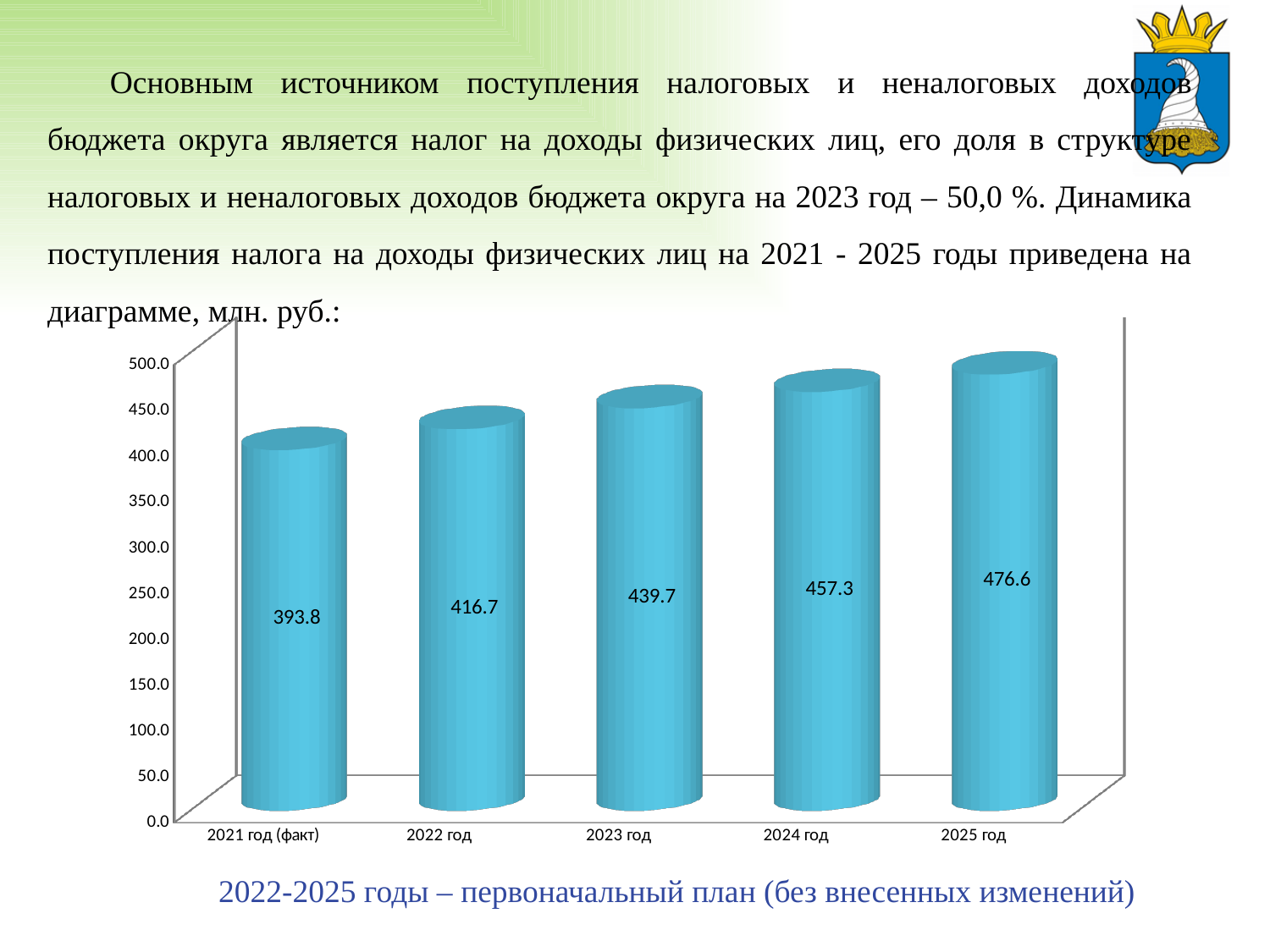
Which year has the lowest value? 2021 год (факт) Is the value for 2022 год greater or less than 400.0? greater Which year has the highest value? 2025 год What is the value for 2023 год? 439.7 Which is larger, the value for 2022 год or the value for 2024 год? 2024 год What is the value for 2025 год? 476.6 Do the values rise or fall from 2021 год (факт) to 2025 год? rise What is the difference between the values for 2024 год and 2023 год? 17.6 What is the difference between the values for 2025 год and 2021 год (факт)? 82.8 What kind of chart is shown on the slide? bar chart How many categories are shown on the x axis? 5 What is the value for 2021 год (факт)? 393.8